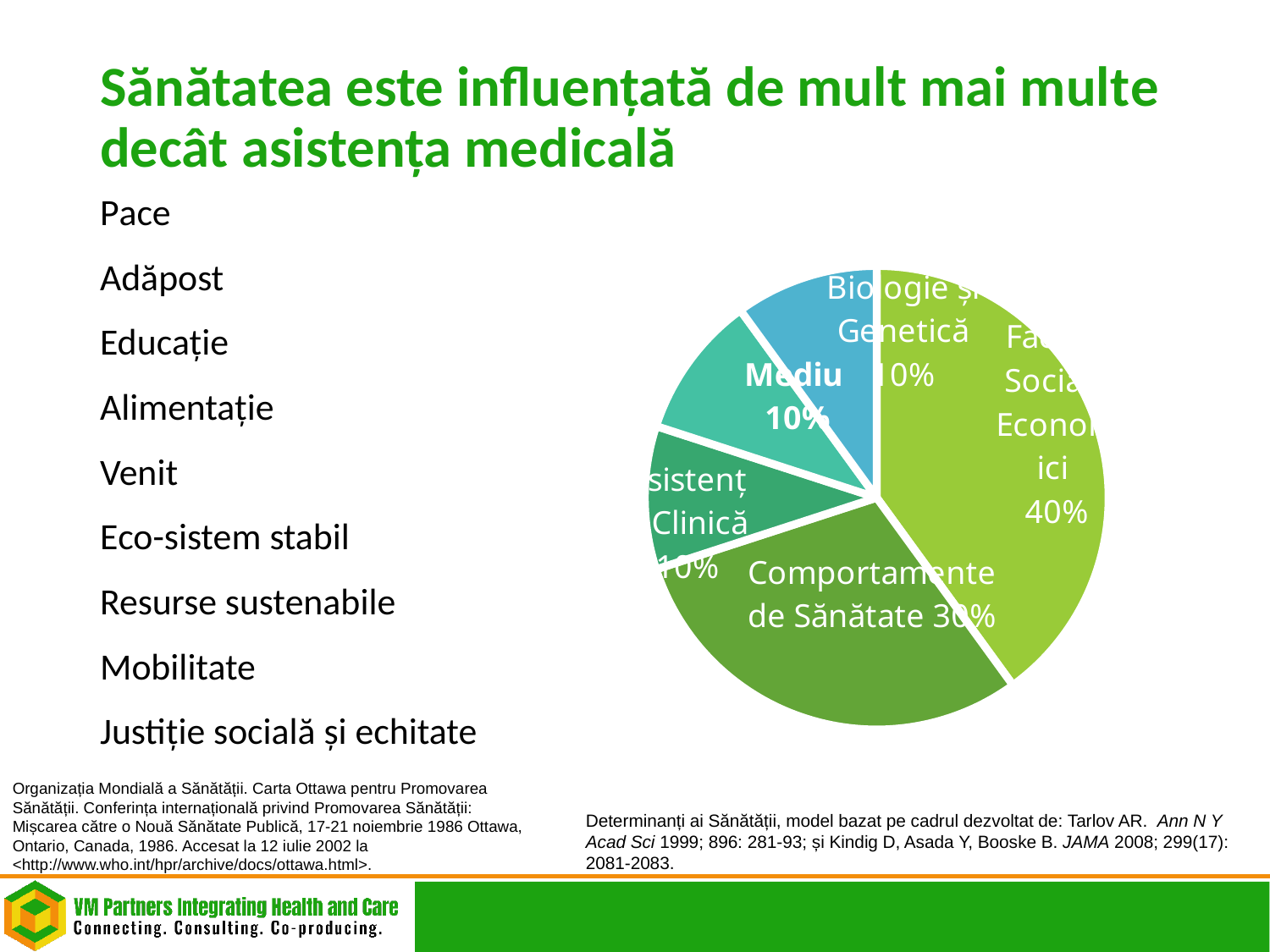
What is the largest percentage value printed on the pie chart? 40% What is the value shown for Biologie și Genetică in the pie chart? 10% What share of the pie does Comportamente de Sănătate represent? 30% What is the difference in percentage points between Comportamente de Sănătate and Biologie și Genetică? 20 Which slice is larger, Comportamente de Sănătate or Mediu? Comportamente de Sănătate What is the title of the slide containing the pie chart? Sănătatea este influențată de mult mai multe decât asistența medicală How many slices does the pie chart have? 5 What is the value shown for Mediu in the pie chart? 10% What kind of chart is shown on the slide? pie chart Is the value for Comportamente de Sănătate greater or less than 20%? greater Which slice is larger, Mediu or Comportamente de Sănătate? Comportamente de Sănătate